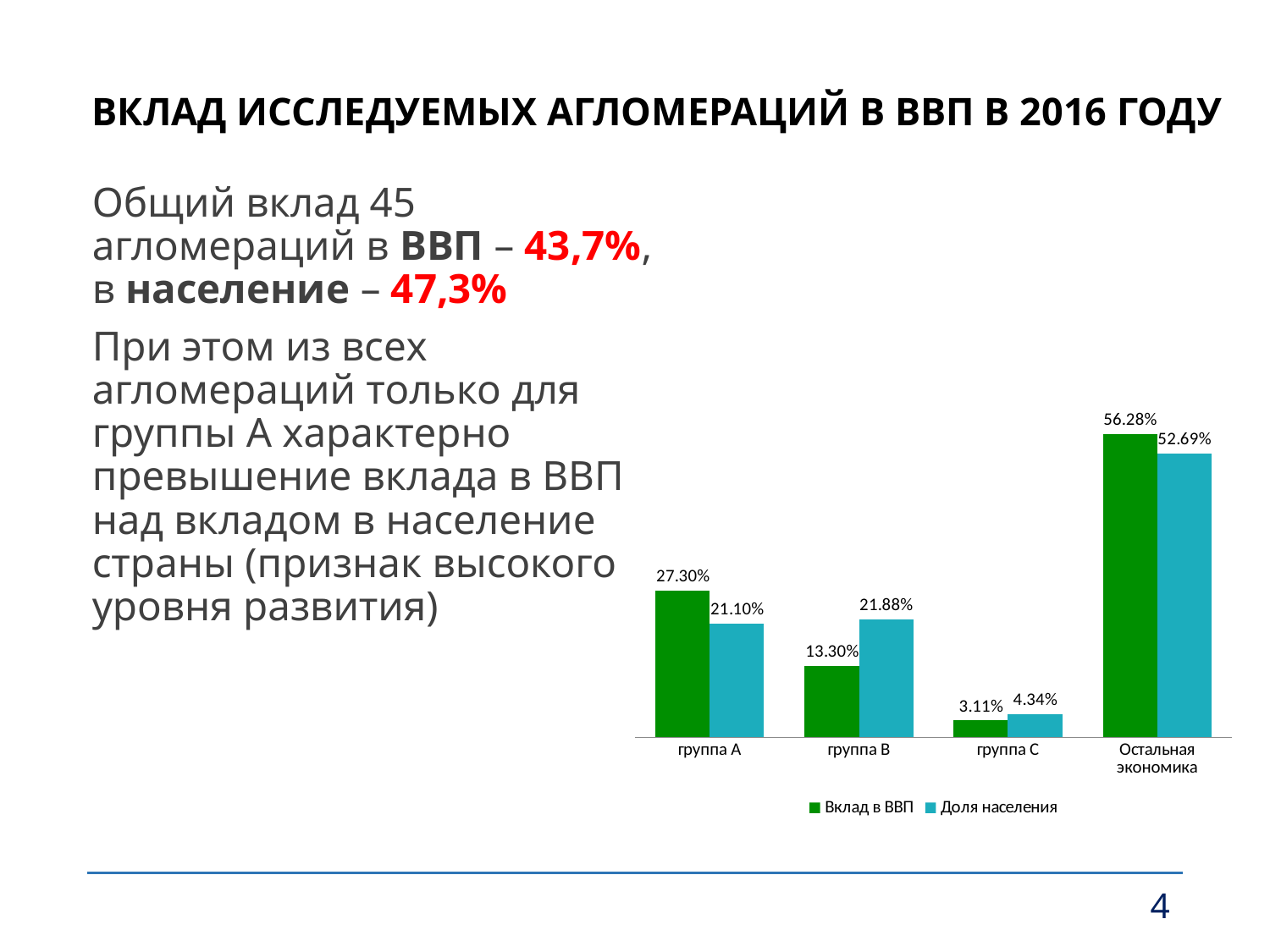
What is the value of Вклад в ВВП for Остальная экономика? 56.28% How many categories are shown on the x axis? 4 Which category has the lowest value for Доля населения? группа C What is the value of Доля населения for группа C? 4.34% How many series does the legend list? 2 What is the difference between Вклад в ВВП and Доля населения for группа A? 6.20% For группа C, which is larger: Вклад в ВВП or Доля населения? Доля населения What is the value of Доля населения for группа B? 21.88% What is the value of Вклад в ВВП for группа A? 27.30% Which category has the highest value for Вклад в ВВП? Остальная экономика What kind of chart is shown on the slide? Bar chart What is the difference between Доля населения and Вклад в ВВП for группа B? 8.58%